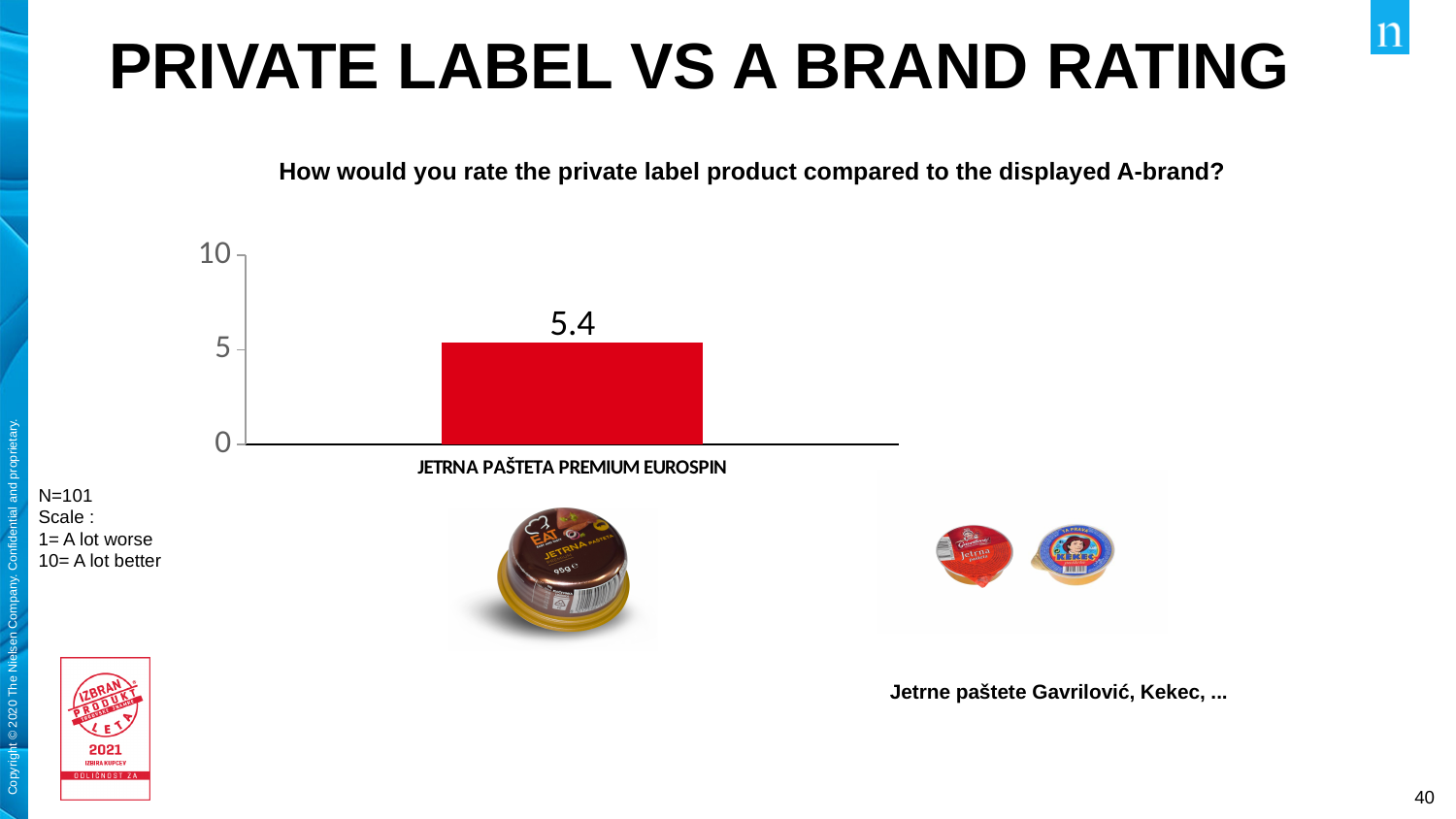
What is the maximum value shown on the y axis? 10 What is the label of the single category on the x axis? JETRNA PAŠTETA PREMIUM EUROSPIN Is the value for JETRNA PAŠTETA PREMIUM EUROSPIN greater or less than 10? less What colour is the bar in the chart? red Is the value for JETRNA PAŠTETA PREMIUM EUROSPIN greater or less than 5? greater How many categories are plotted in the chart? 1 What kind of chart is shown on the slide? bar chart What is the value shown for JETRNA PAŠTETA PREMIUM EUROSPIN? 5.4